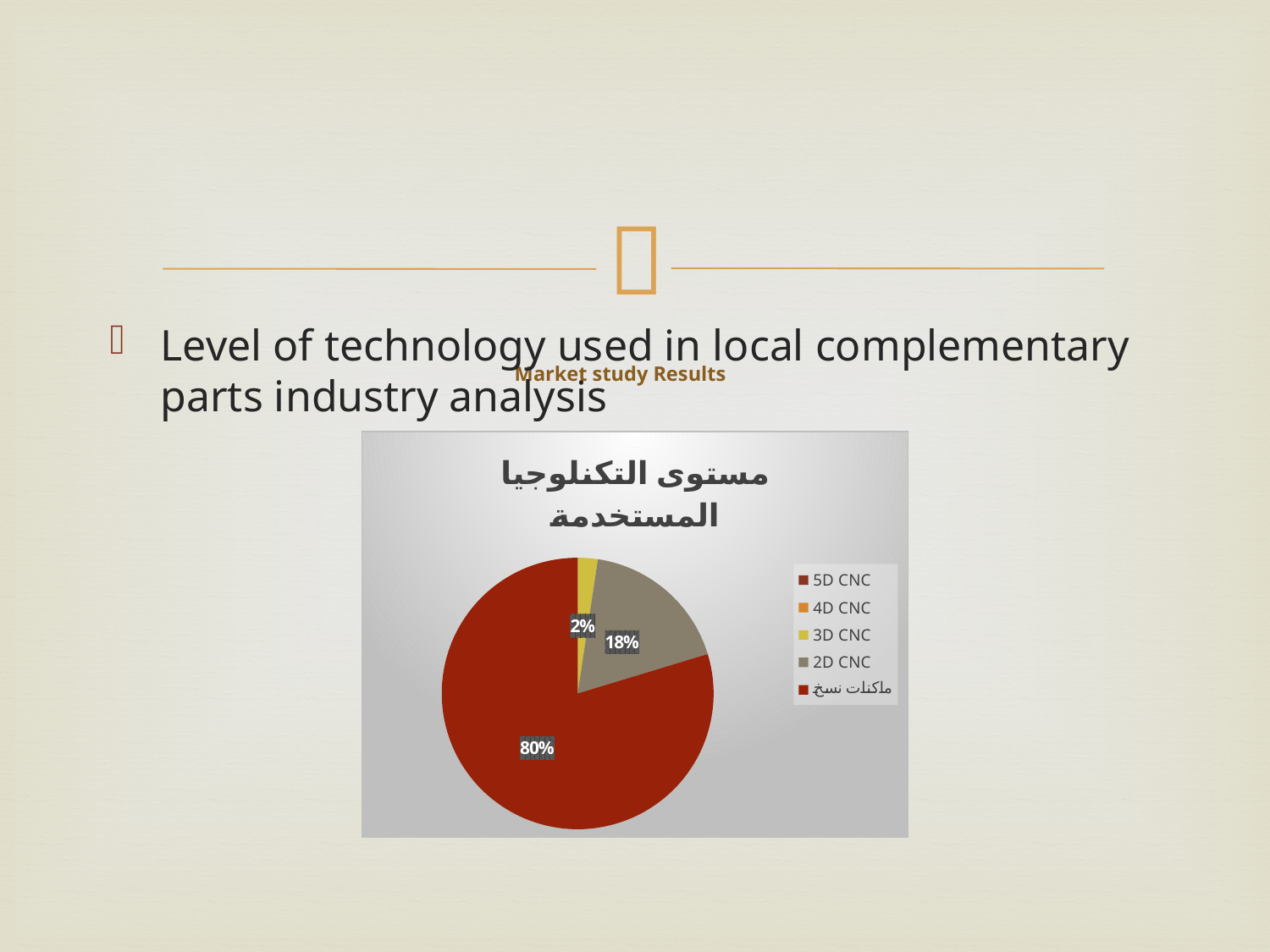
What is the difference in percentage points between the largest slice (80%) and the 2D CNC slice? 62 What kind of chart is shown on the slide? pie chart What percentage is labelled on the 3D CNC slice of the pie? 2% Which legend entries are CNC categories? 5D CNC, 4D CNC, 3D CNC, 2D CNC What colour is the 2D CNC slice of the pie? grey-brown What is the smallest percentage labelled on the pie chart? 2% What percentage is labelled on the 2D CNC slice of the pie? 18% What is the largest percentage labelled on the pie chart? 80% What do the three labelled slices of the pie add up to? 100% What is the difference in percentage points between the 2D CNC slice and the 3D CNC slice? 16 Which slice is larger, 2D CNC or 3D CNC? 2D CNC How many entries does the chart's legend list? 5